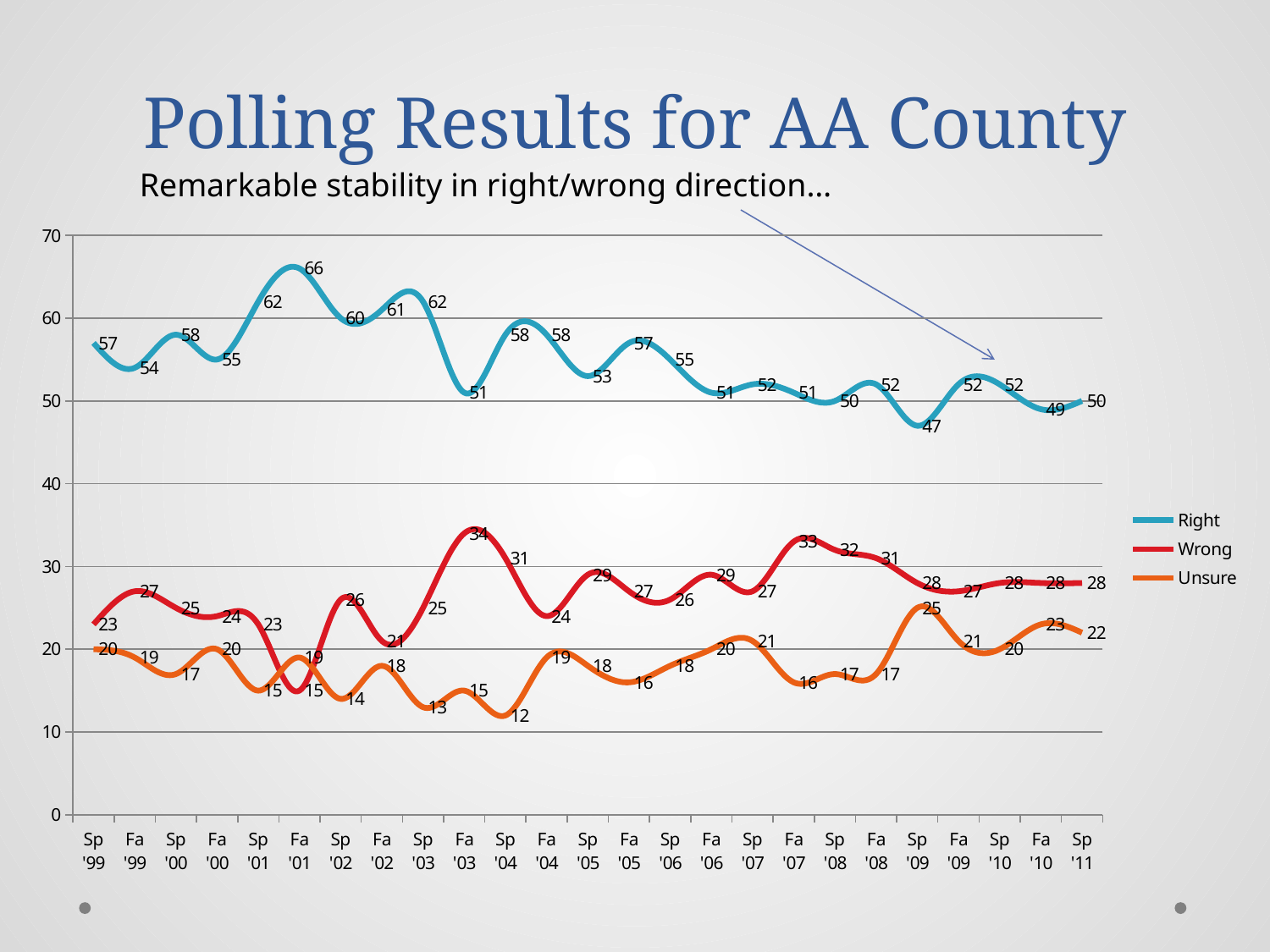
What is the value of the Unsure series at Sp '09? 25 How many time periods are shown on the x axis? 25 At which period does the Wrong series reach its highest value? Fa '03 What is the title of the chart slide? Polling Results for AA County What is the value of the Wrong series at Fa '03? 34 What is the value of the Right series at Fa '01? 66 At which period does the Unsure series reach its lowest value? Sp '04 At which period does the Right series reach its lowest value? Sp '09 What is the difference between the Right value at Sp '99 and the Right value at Sp '11? 7 What kind of chart is shown on the slide? line chart Which is larger at Fa '01: the Wrong value or the Unsure value? Unsure How many series does the legend list? 3